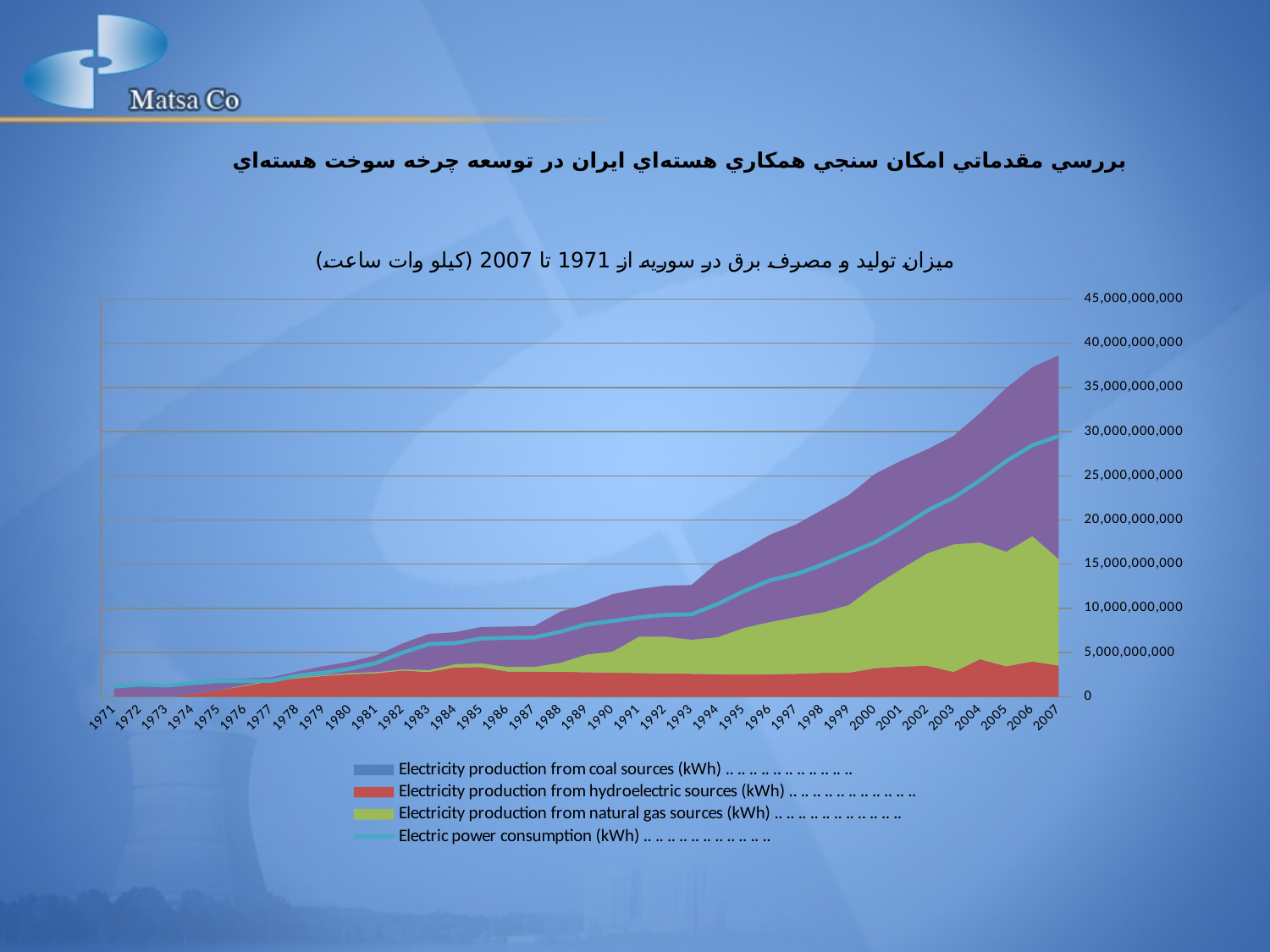
Is the value for Electric power consumption (kWh) in 1971 greater or less than 5,000,000,000? less What is the first year shown on the x axis? 1971 What kind of chart is shown on the slide? combination area and line chart Which year has the highest value for Electric power consumption (kWh)? 2007 In 2007, which is larger: Electricity production from natural gas sources (kWh) or Electricity production from hydroelectric sources (kWh)? Electricity production from natural gas sources (kWh) Is the value for Electric power consumption (kWh) in 2007 greater or less than 25,000,000,000? greater Is the value for Electricity production from hydroelectric sources (kWh) in 2007 greater or less than 5,000,000,000? less How many series does the legend list? 4 Does Electric power consumption (kWh) rise or fall from 1971 to 2007? rise What is the last year shown on the x axis? 2007 How many years are plotted along the x axis? 37